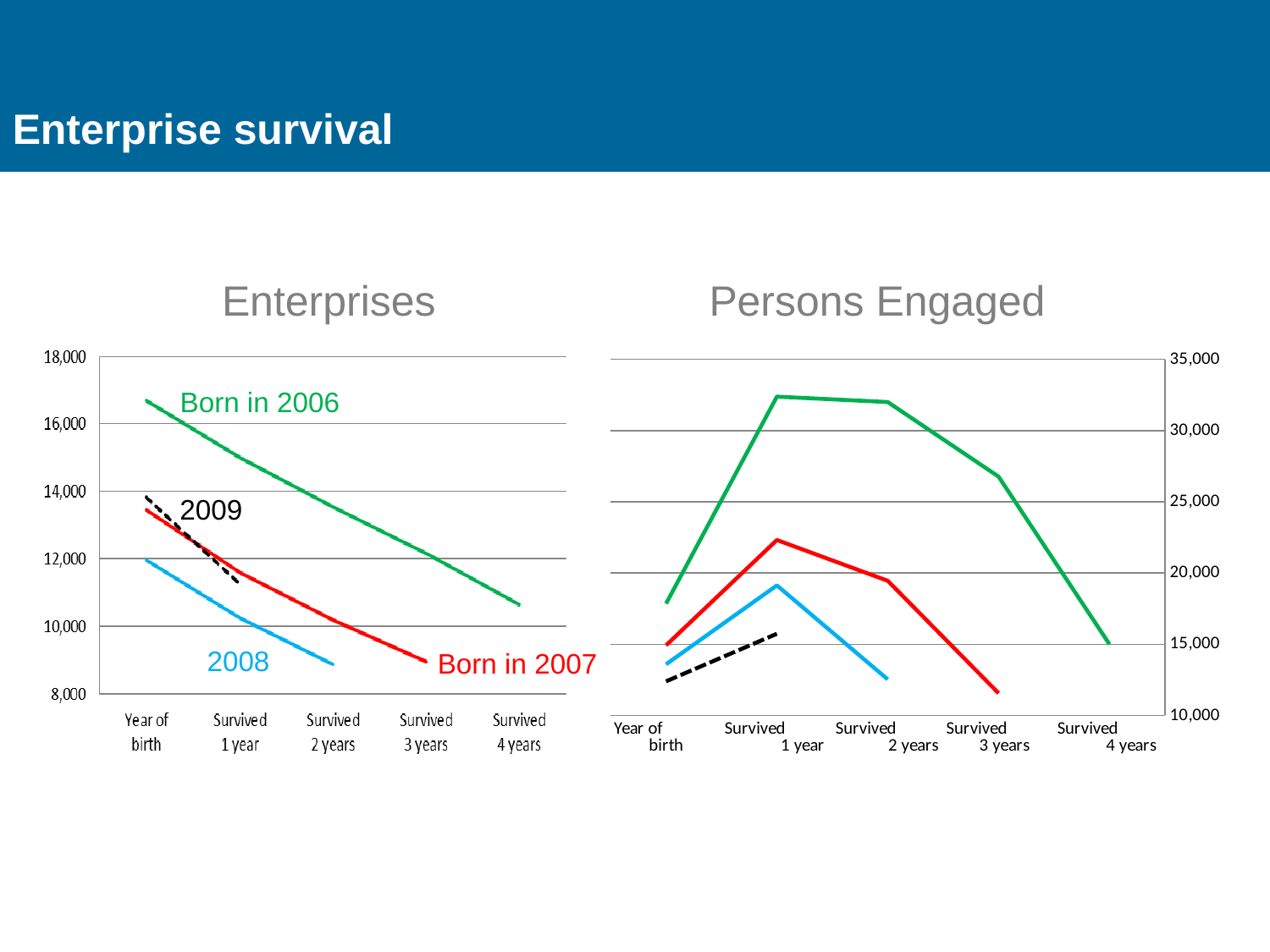
In the Enterprises chart, which is larger at Year of birth: Born in 2006 or Born in 2007? Born in 2006 What colour is the Born in 2006 line in the Enterprises chart? green In the Enterprises chart, is the value for 2008 at Survived 2 years greater or less than 10,000? less In the Enterprises chart, does the Born in 2006 line rise or fall from Year of birth to Survived 4 years? fall How many series are labelled on the Enterprises chart? 4 In the Enterprises chart, is the value for Born in 2007 at Year of birth greater or less than 14,000? less What kind of chart is the Enterprises chart? line chart How many categories are shown on the x axis of the Persons Engaged chart? 5 In the Enterprises chart, is the value for Born in 2006 at Year of birth greater or less than 16,000? greater In the Enterprises chart, which series has the highest value at Year of birth? Born in 2006